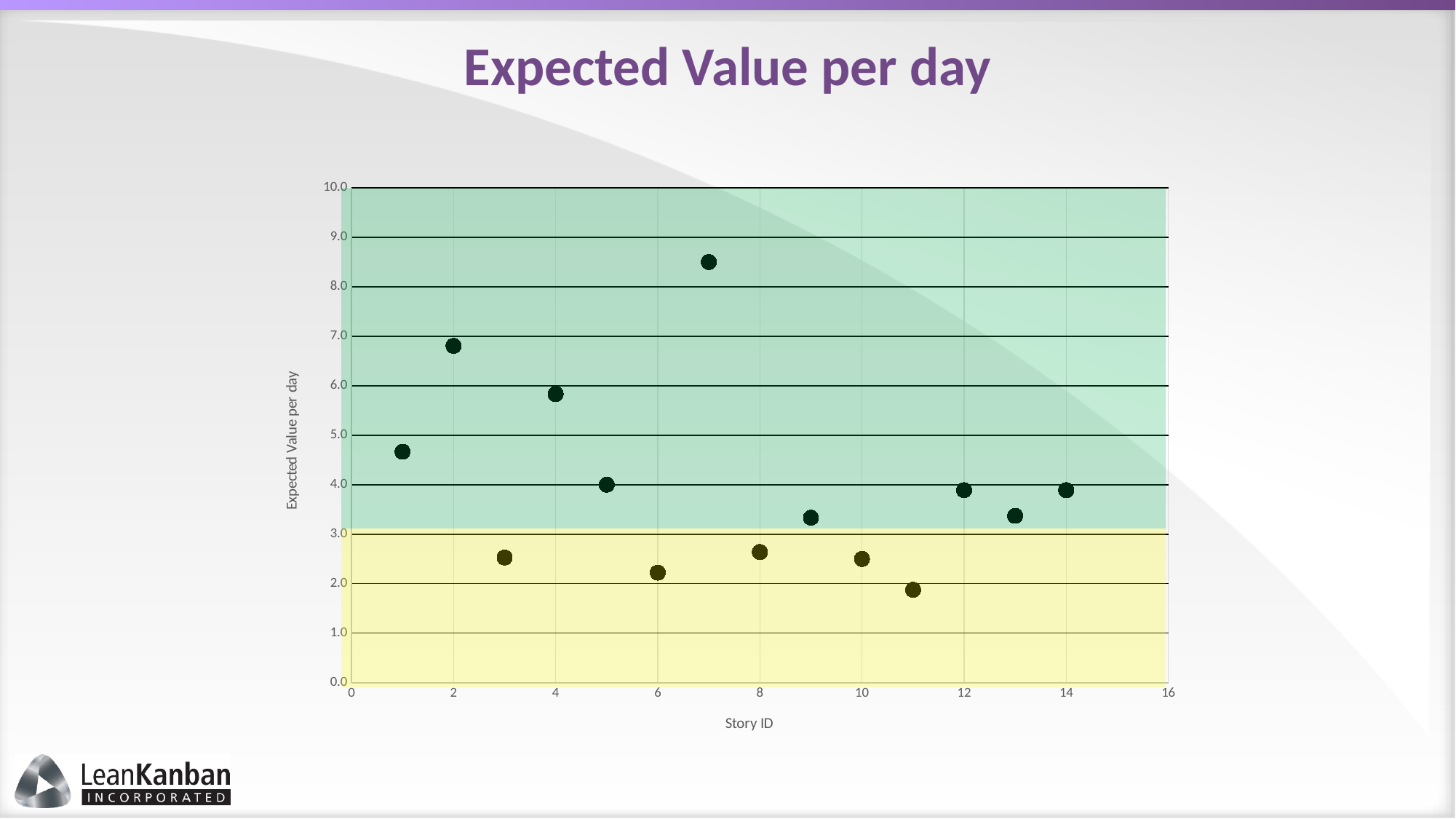
Is the value for Story ID 7 greater or less than 8.0? greater How many data points are plotted on the chart? 14 What kind of chart is shown on the slide? scatter chart Which Story ID has the lowest expected value per day? 11 Which has a higher expected value per day, Story ID 3 or Story ID 11? Story ID 3 Which Story ID has the highest expected value per day? 7 What is the label of the x axis? Story ID Is the value for Story ID 1 greater or less than 5.0? less Is the value for Story ID 6 greater or less than 3.0? less Which has a higher expected value per day, Story ID 2 or Story ID 4? Story ID 2 What is the title of the chart? Expected Value per day